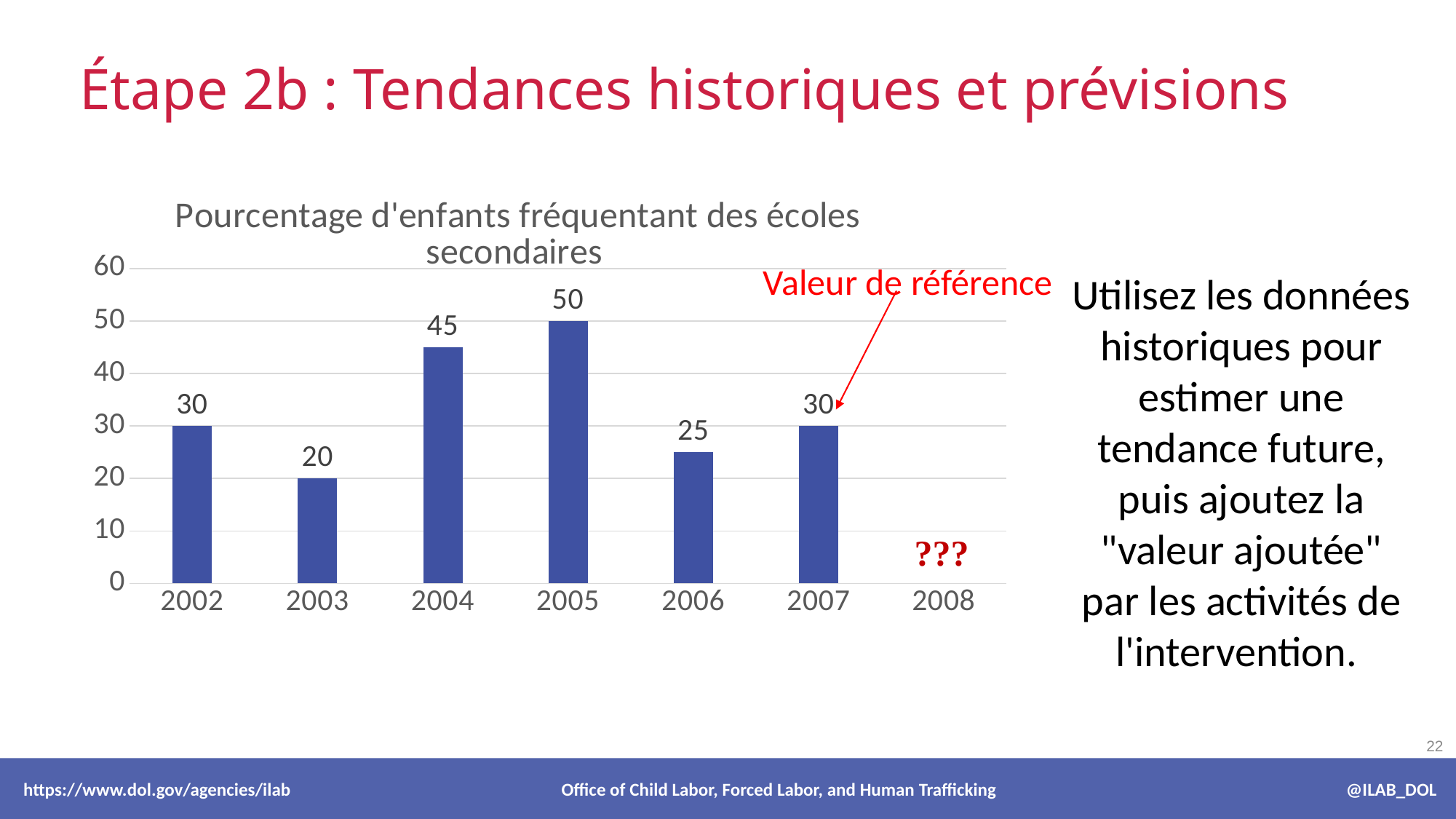
Which year is labelled with '???' instead of a bar? 2008 What is the title of the chart? Pourcentage d'enfants fréquentant des écoles secondaires Which year has the highest value? 2005 What is the value for 2007, marked as the 'Valeur de référence'? 30 What is the value for 2006? 25 Is the value for 2005 greater or less than 40? greater How many years are shown on the x axis? 7 What is the value for 2004? 45 Which is larger, the value for 2004 or the value for 2006? 2004 What is the difference between the values for 2005 and 2003? 30 Which year has the lowest plotted value? 2003 What kind of chart is shown on the slide? bar chart